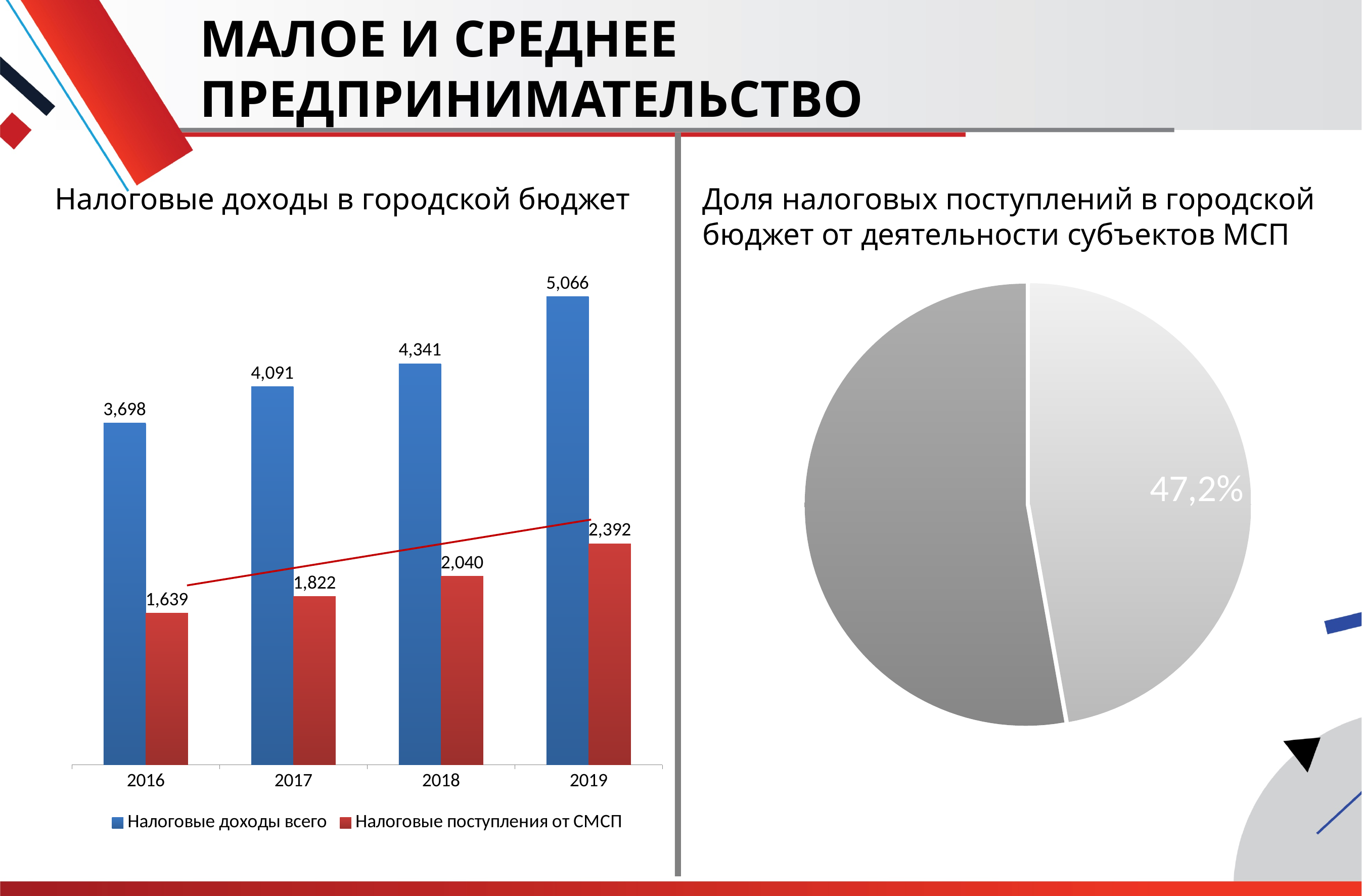
In the chart 'Налоговые доходы в городской бюджет', which year has the highest value for 'Налоговые поступления от СМСП'? 2019 In the chart 'Налоговые доходы в городской бюджет', how many series does the legend list? 2 What kind of chart is the one on the right of the slide, titled 'Доля налоговых поступлений в городской бюджет от деятельности субъектов МСП'? pie chart In the chart 'Налоговые доходы в городской бюджет', do the values of 'Налоговые доходы всего' rise or fall from 2016 to 2019? rise In the chart 'Налоговые доходы в городской бюджет', which is larger: 'Налоговые поступления от СМСП' in 2018 or 'Налоговые поступления от СМСП' in 2016? 2018 In the chart 'Налоговые доходы в городской бюджет', what is the value of 'Налоговые доходы всего' for 2019? 5,066 In the chart 'Налоговые доходы в городской бюджет', what is the difference between 'Налоговые доходы всего' and 'Налоговые поступления от СМСП' in 2018? 2,301 In the chart 'Налоговые доходы в городской бюджет', which year has the lowest value for 'Налоговые доходы всего'? 2016 In the chart 'Налоговые доходы в городской бюджет', by how much did 'Налоговые доходы всего' increase from 2016 to 2019? 1,368 In the pie chart on the right of the slide, what percentage is printed on the light-coloured slice? 47,2% In the chart 'Налоговые доходы в городской бюджет', how many years are shown on the x axis? 4 In the chart 'Налоговые доходы в городской бюджет', what is the value of 'Налоговые поступления от СМСП' for 2017? 1,822